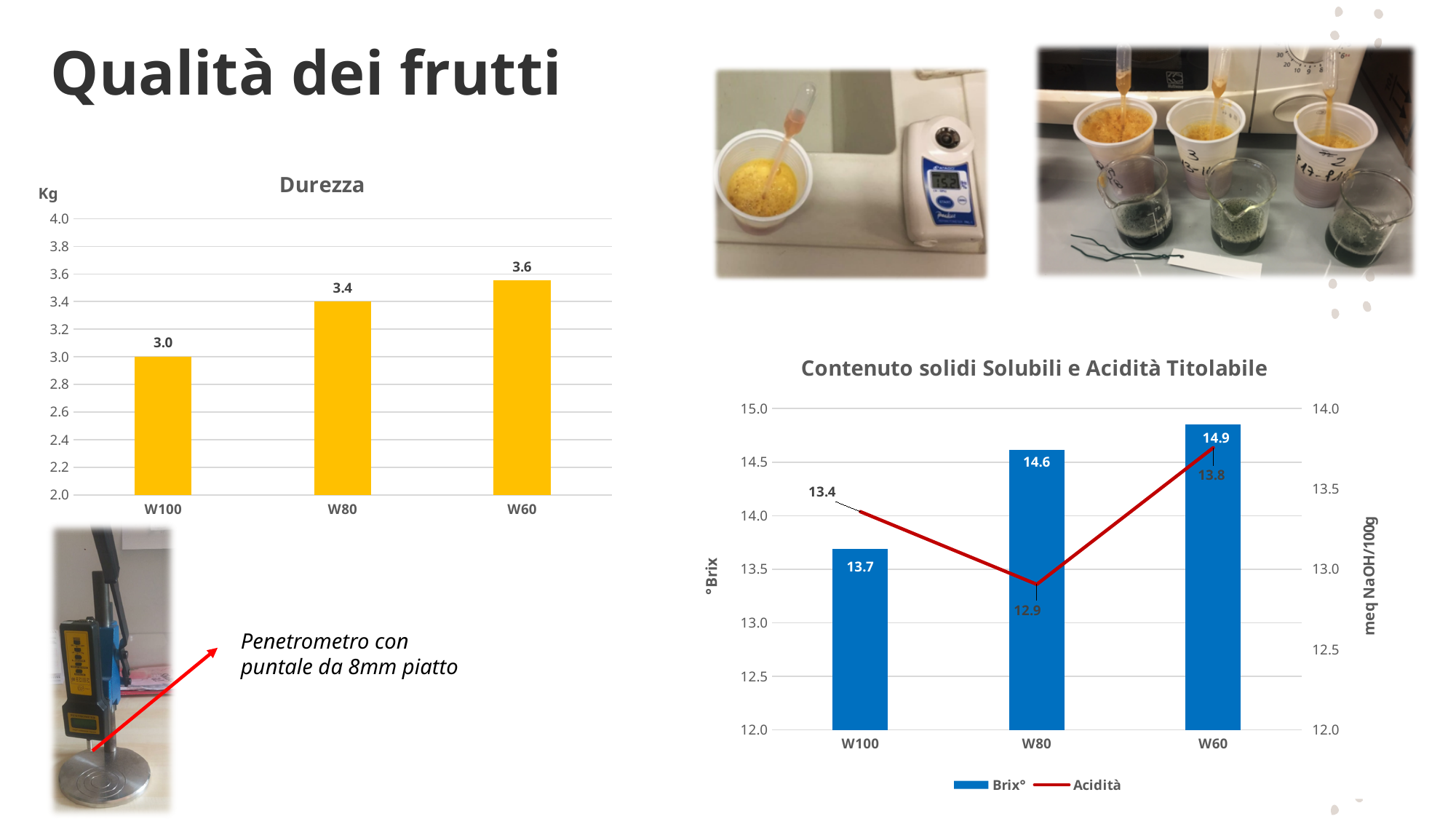
What kind of chart is the 'Durezza' chart? bar chart In the 'Durezza' chart, what is the difference between the values for W60 and W100? 0.6 In the 'Durezza' chart, how many categories are shown? 3 In the 'Contenuto solidi Solubili e Acidità Titolabile' chart, how many series does the legend list? 2 In the 'Contenuto solidi Solubili e Acidità Titolabile' chart, what is the Acidità value for W100? 13.4 In the 'Contenuto solidi Solubili e Acidità Titolabile' chart, what is the Brix° value for W80? 14.6 In the 'Durezza' chart, what is the value for W80? 3.4 In the 'Durezza' chart, do the values rise or fall from W100 to W60? rise In the 'Contenuto solidi Solubili e Acidità Titolabile' chart, which is larger, the Brix° value for W60 or for W100? W60 In the 'Durezza' chart, which category has the lowest value? W100 In the 'Contenuto solidi Solubili e Acidità Titolabile' chart, which category has the lowest Acidità value? W80 In the 'Durezza' chart, which category has the highest value? W60